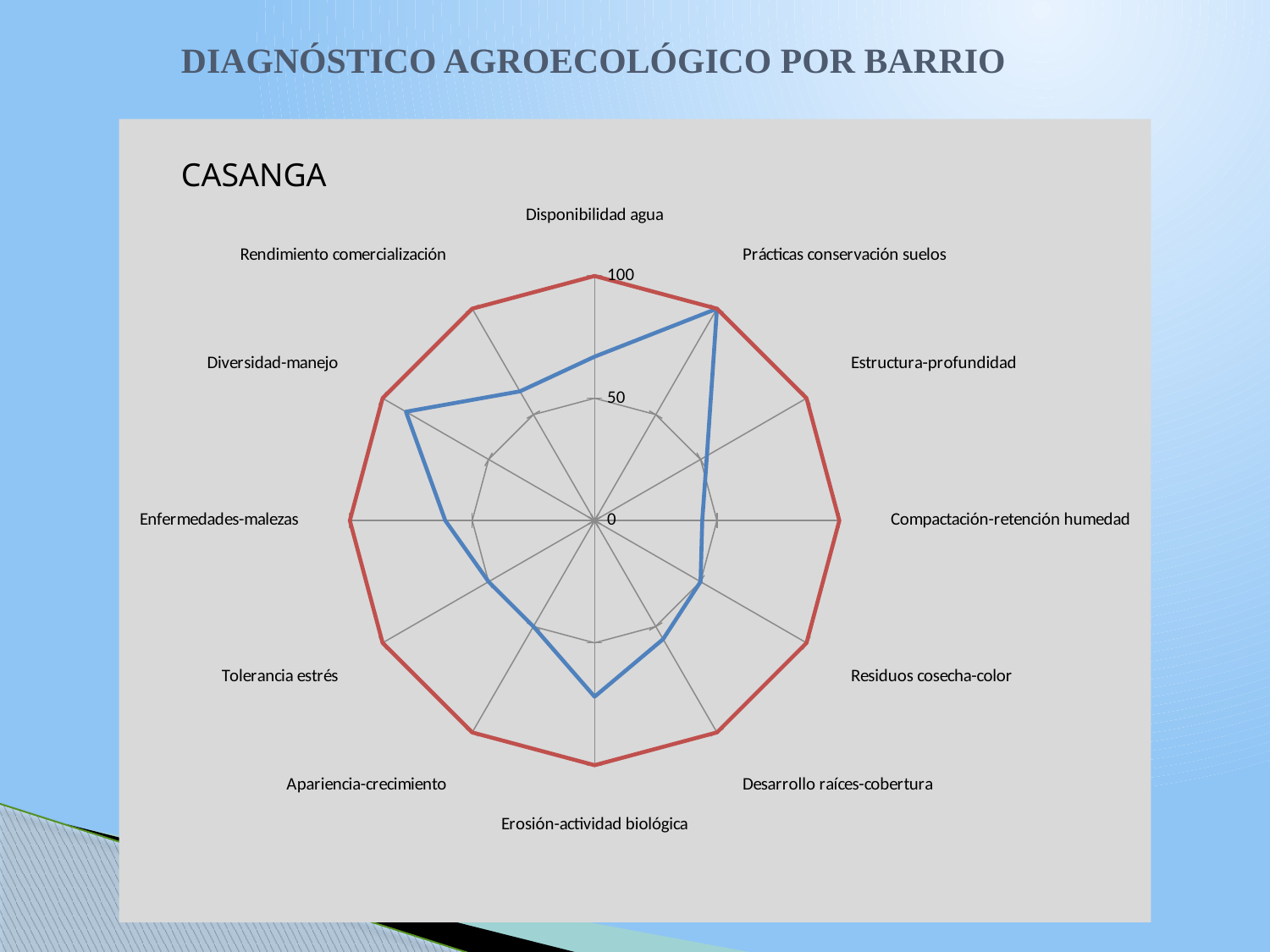
On the blue line, which is larger: Diversidad-manejo or Tolerancia estrés? Diversidad-manejo Is the blue line's value for Prácticas conservación suelos greater or less than 50? greater How many categories (axes) does the radar chart have? 12 What is the maximum value shown on the radar chart's axis scale? 100 Is the blue line's value for Erosión-actividad biológica greater or less than 50? greater Is the red line's value for Compactación-retención humedad greater or less than 50? greater What kind of chart is shown on the slide? Radar chart What is the title shown above the radar chart? CASANGA Which category has the highest value on the blue line? Prácticas conservación suelos On the blue line, which is larger: Prácticas conservación suelos or Erosión-actividad biológica? Prácticas conservación suelos